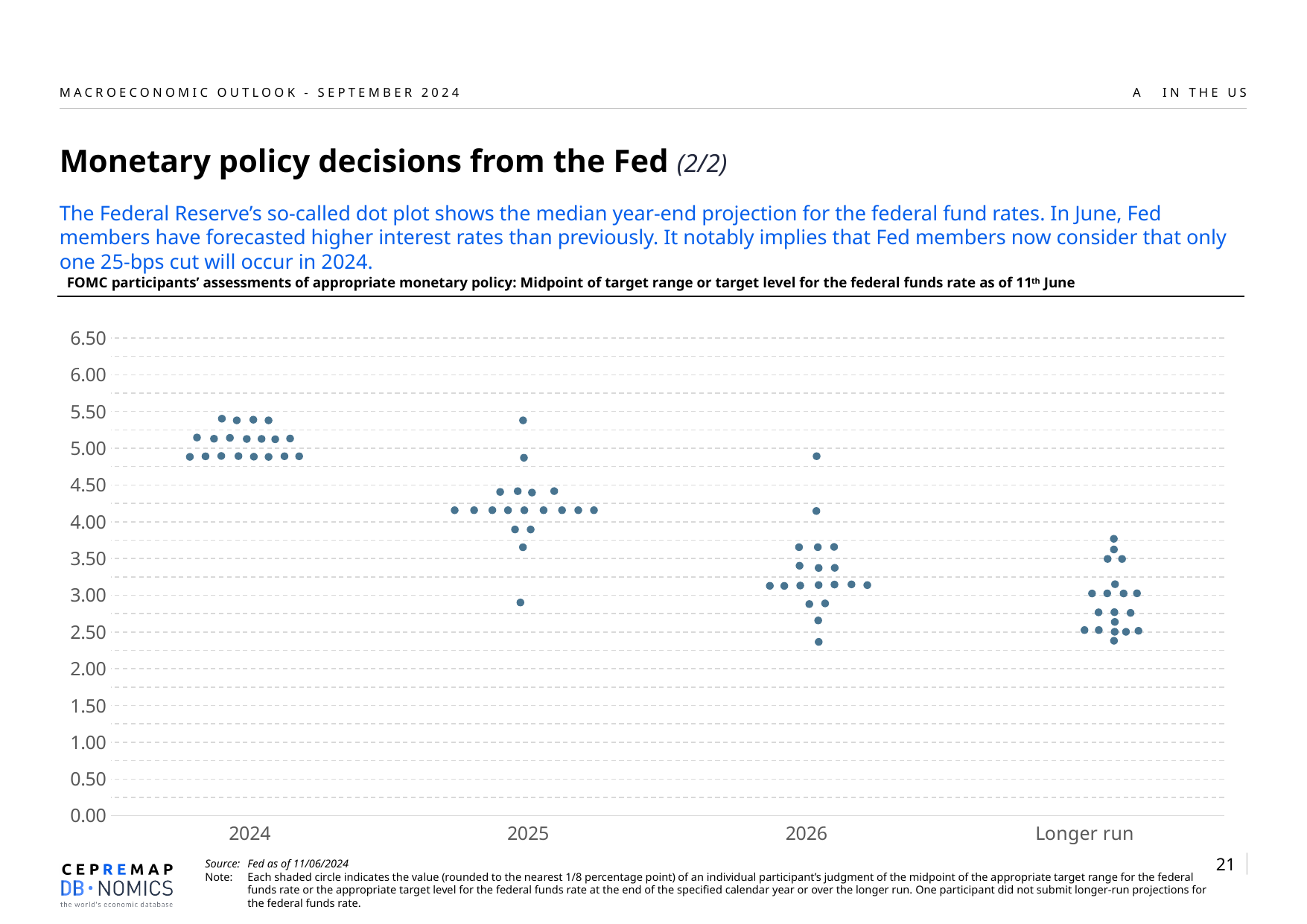
What kind of chart is shown on the slide? Dot plot (scatter chart) How many dots are plotted for 2024? 19 Is the highest dot for 2025 greater or less than 5.00? greater Is the lowest dot for 2024 greater or less than 4.50? greater Is the highest dot for 2024 greater or less than 5.00? greater Do the dots generally rise or fall moving from 2024 to Longer run along the x axis? fall What are the categories on the x axis of the chart? 2024, 2025, 2026, Longer run Which has a higher lowest dot: 2024 or 2025? 2024 How many categories are shown along the x axis of the chart? 4